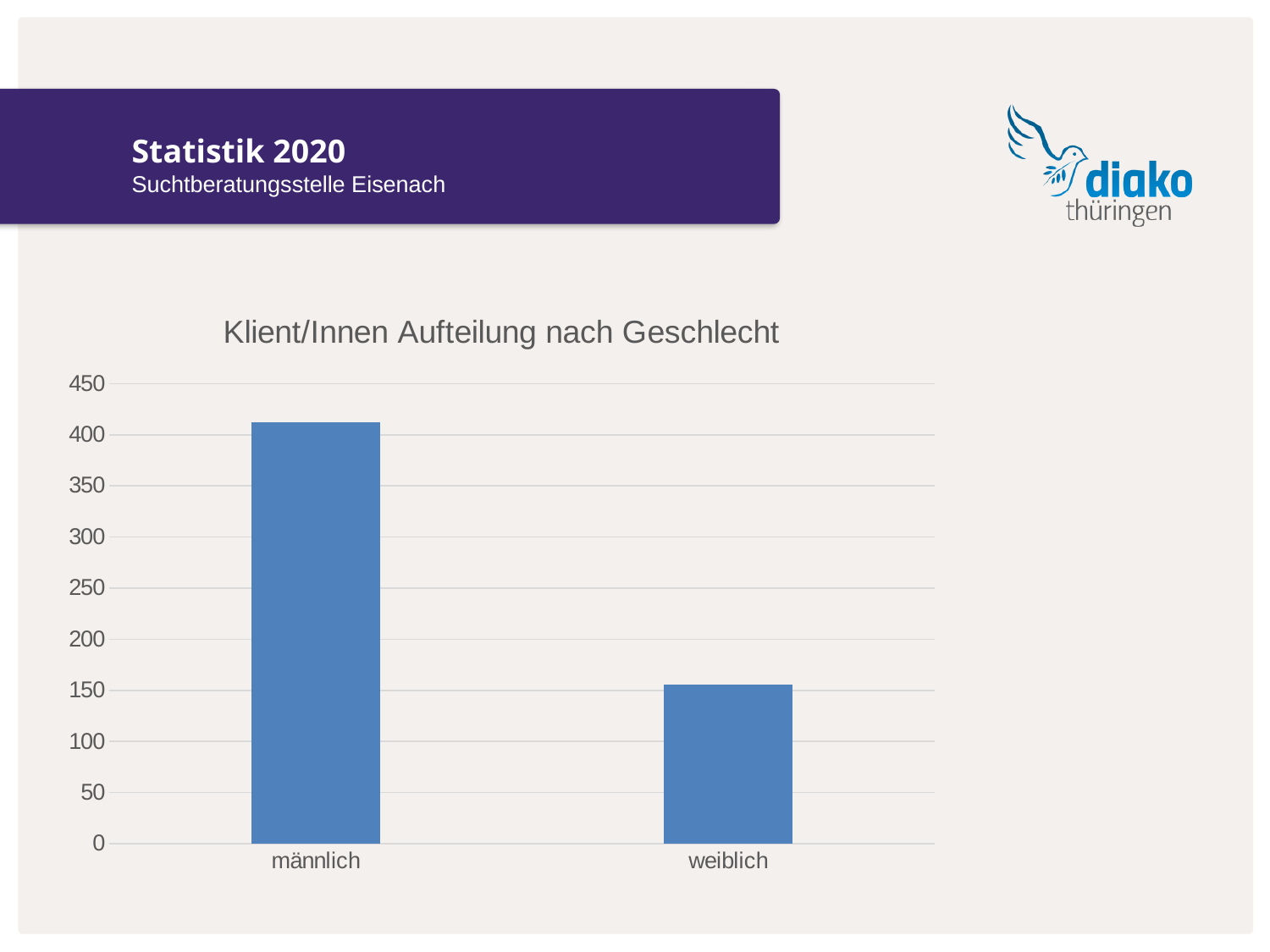
Which is larger, the value for männlich or the value for weiblich? männlich Is the value for männlich greater or less than 450? less Is the value for weiblich greater or less than 200? less Which category has the lowest value? weiblich Is the value for männlich greater or less than 400? greater What kind of chart is shown on the slide? bar chart How many categories are shown on the x axis? 2 What is the highest value shown on the y axis? 450 What is the title of the chart? Klient/Innen Aufteilung nach Geschlecht Which category has the highest value? männlich